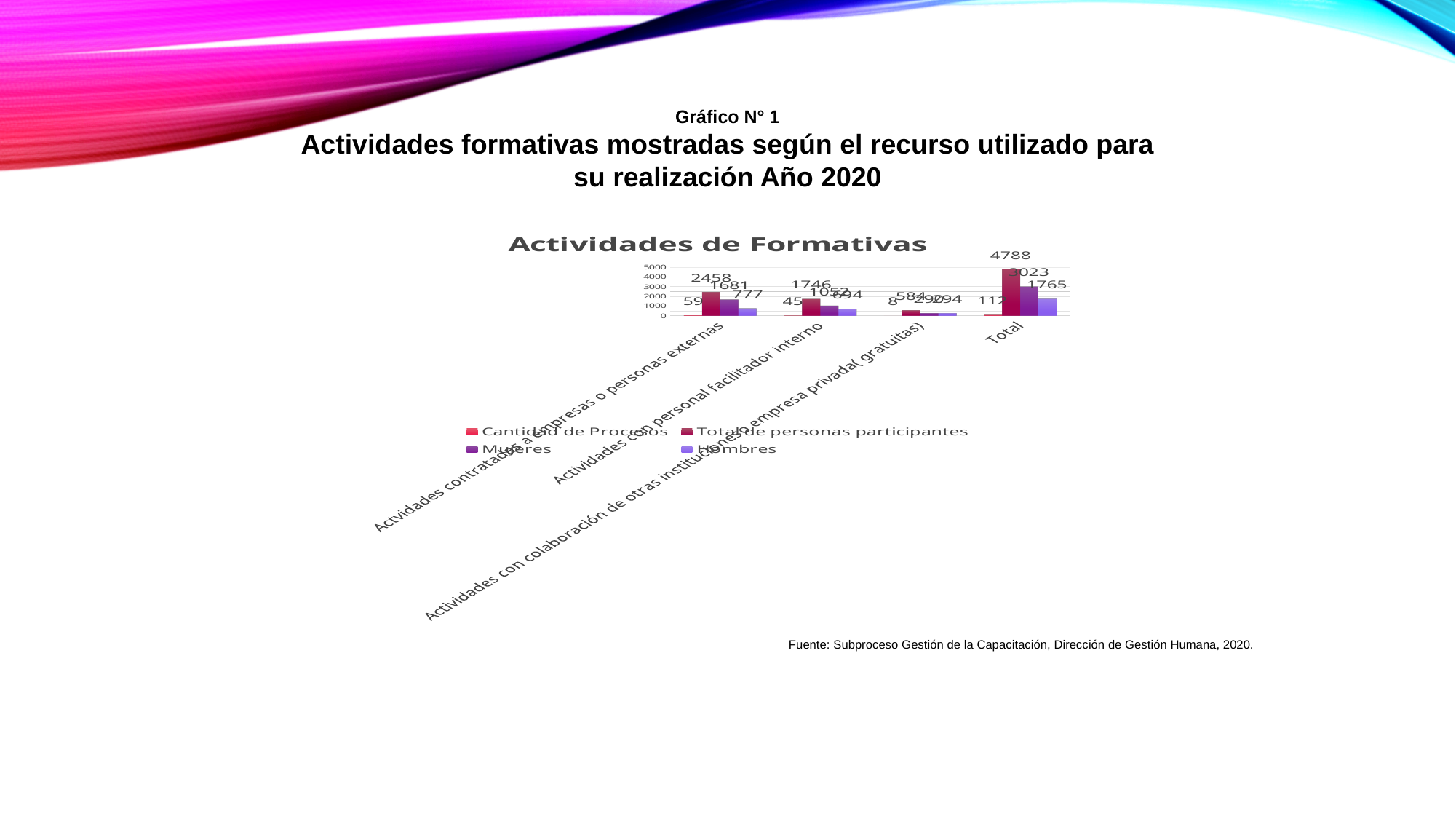
What is the value of Hombres for the Total category? 1765 What is the value of Hombres for Actividades con personal facilitador interno? 694 What kind of chart is shown on the slide? bar chart What is the value of Mujeres for the Total category? 3023 What is the value of Total de personas participantes for Actividades con personal facilitador interno? 1746 How many categories are shown on the x axis of the chart? 4 For Actividades contratadas a empresas o personas externas, which is larger, Mujeres or Hombres? Mujeres What is the difference between Mujeres and Hombres in the Total category? 1258 What is the title of the chart? Actividades de Formativas What is the value of Total de personas participantes for Actividades contratadas a empresas o personas externas? 2458 How many series does the legend of the chart list? 4 What is the value of Total de personas participantes for the Total category? 4788